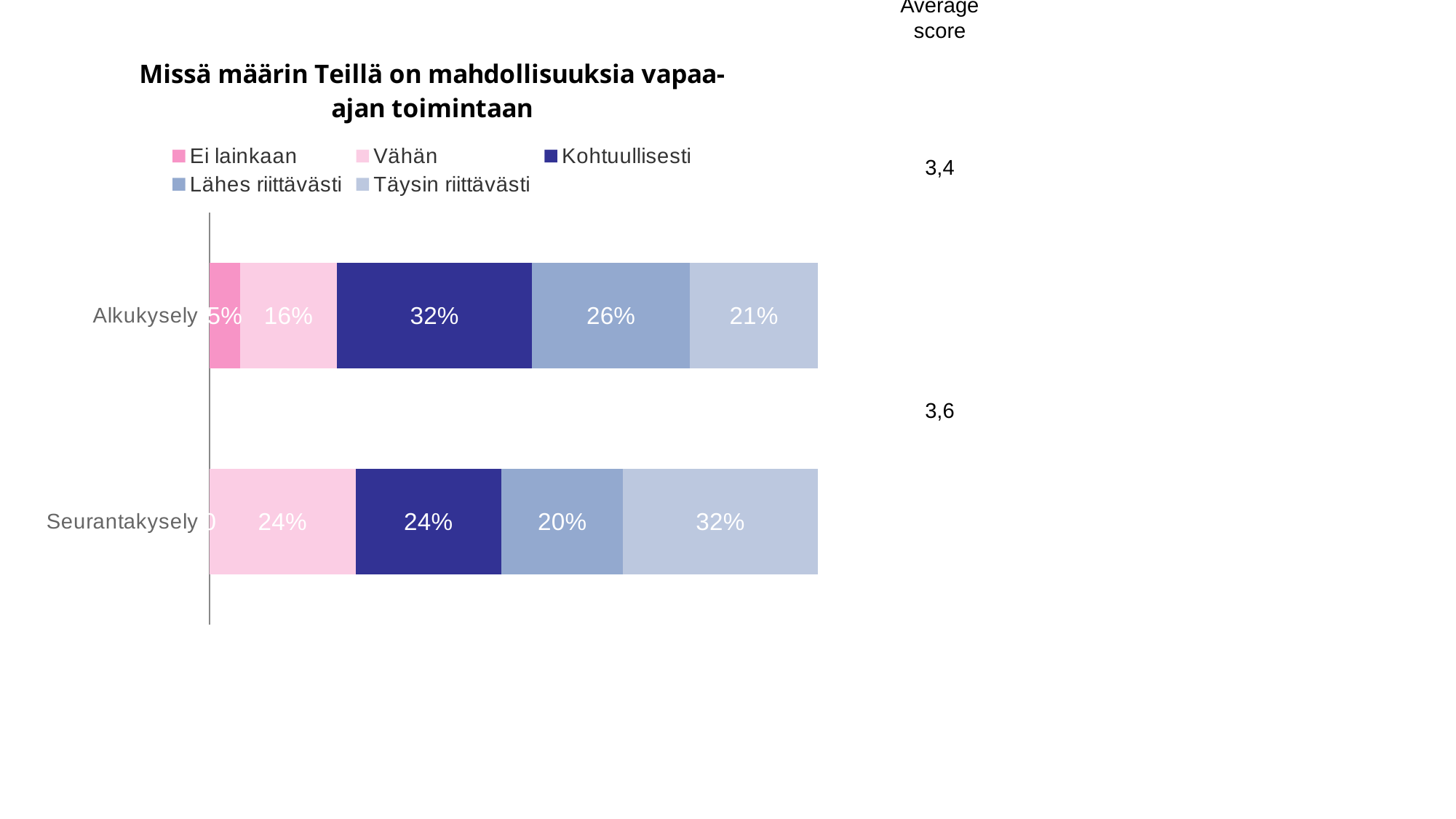
Which is larger: Lähes riittävästi for Alkukysely or Lähes riittävästi for Seurantakysely? Alkukysely How many categories are plotted on the chart? 2 What is the value for Kohtuullisesti in the Alkukysely bar? 32% What is the difference between the Täysin riittävästi values for Seurantakysely and Alkukysely? 11% Which segment is the smallest in the Alkukysely bar? Ei lainkaan What kind of chart is shown on the slide? Stacked bar chart What is the title of the chart? Missä määrin Teillä on mahdollisuuksia vapaa-ajan toimintaan Which segment is the largest in the Alkukysely bar? Kohtuullisesti What is the value for Täysin riittävästi in the Seurantakysely bar? 32% What is the value for Vähän in the Alkukysely bar? 16% How many series does the legend list? 5 What is the value for Lähes riittävästi in the Seurantakysely bar? 20%